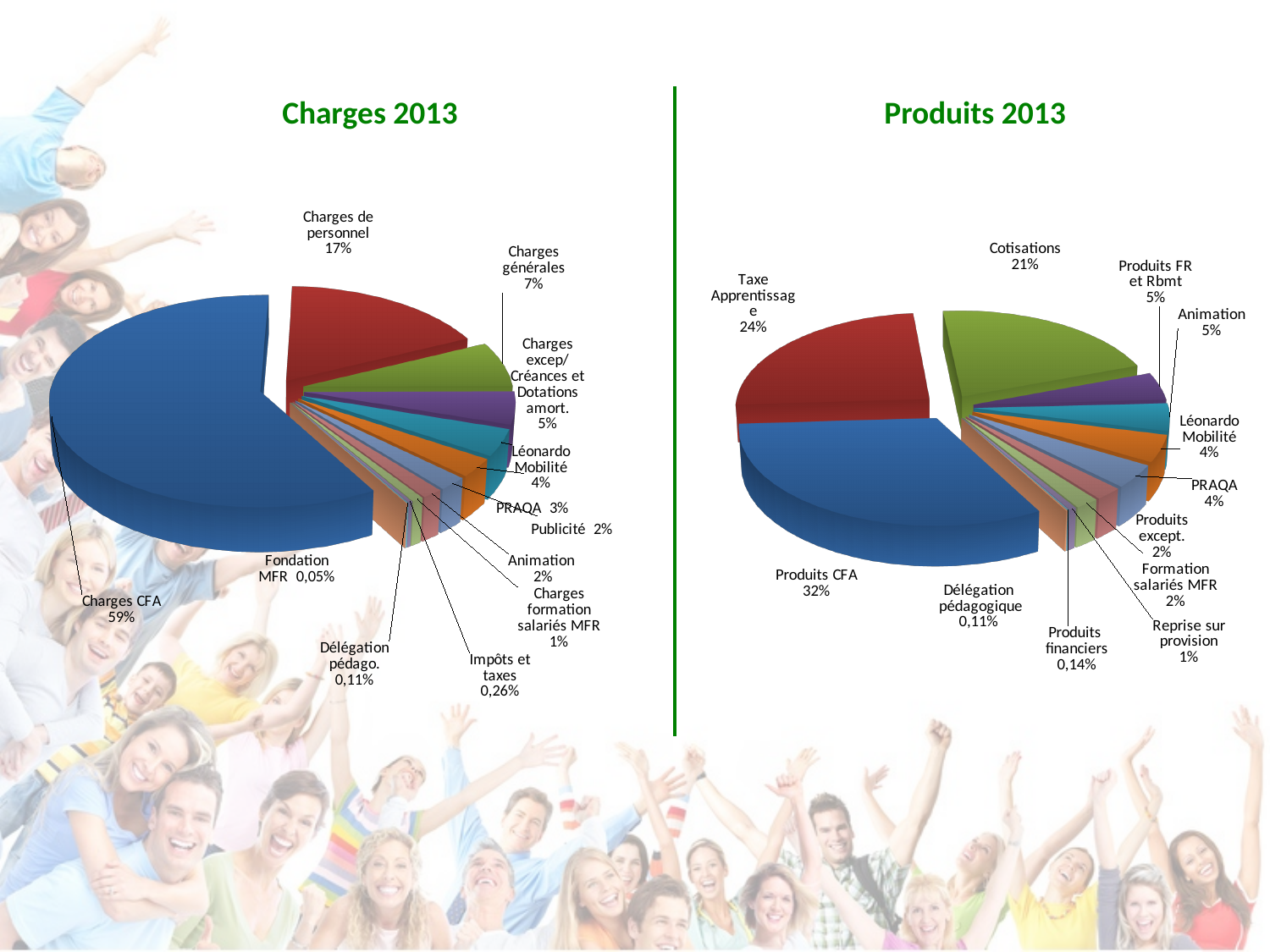
In the Charges 2013 chart, what share does Charges CFA represent? 59% In the Produits 2013 chart, what is the share for Produits financiers? 0,14% How many slices does the Charges 2013 pie chart have? 12 In the Charges 2013 chart, what is the share for Impôts et taxes? 0,26% In the Produits 2013 chart, what is the share for Taxe Apprentissage? 24% What kind of chart is the Charges 2013 chart? pie chart In the Produits 2013 chart, what is the difference between Produits CFA and Cotisations? 11% In the Charges 2013 chart, which category has the smallest share? Fondation MFR In the Produits 2013 chart, which is larger: Cotisations or Taxe Apprentissage? Taxe Apprentissage In the Charges 2013 chart, what is the difference between Charges générales and Léonardo Mobilité? 3% In the Charges 2013 chart, what is the share for Charges de personnel? 17% In the Produits 2013 chart, which category has the largest share? Produits CFA